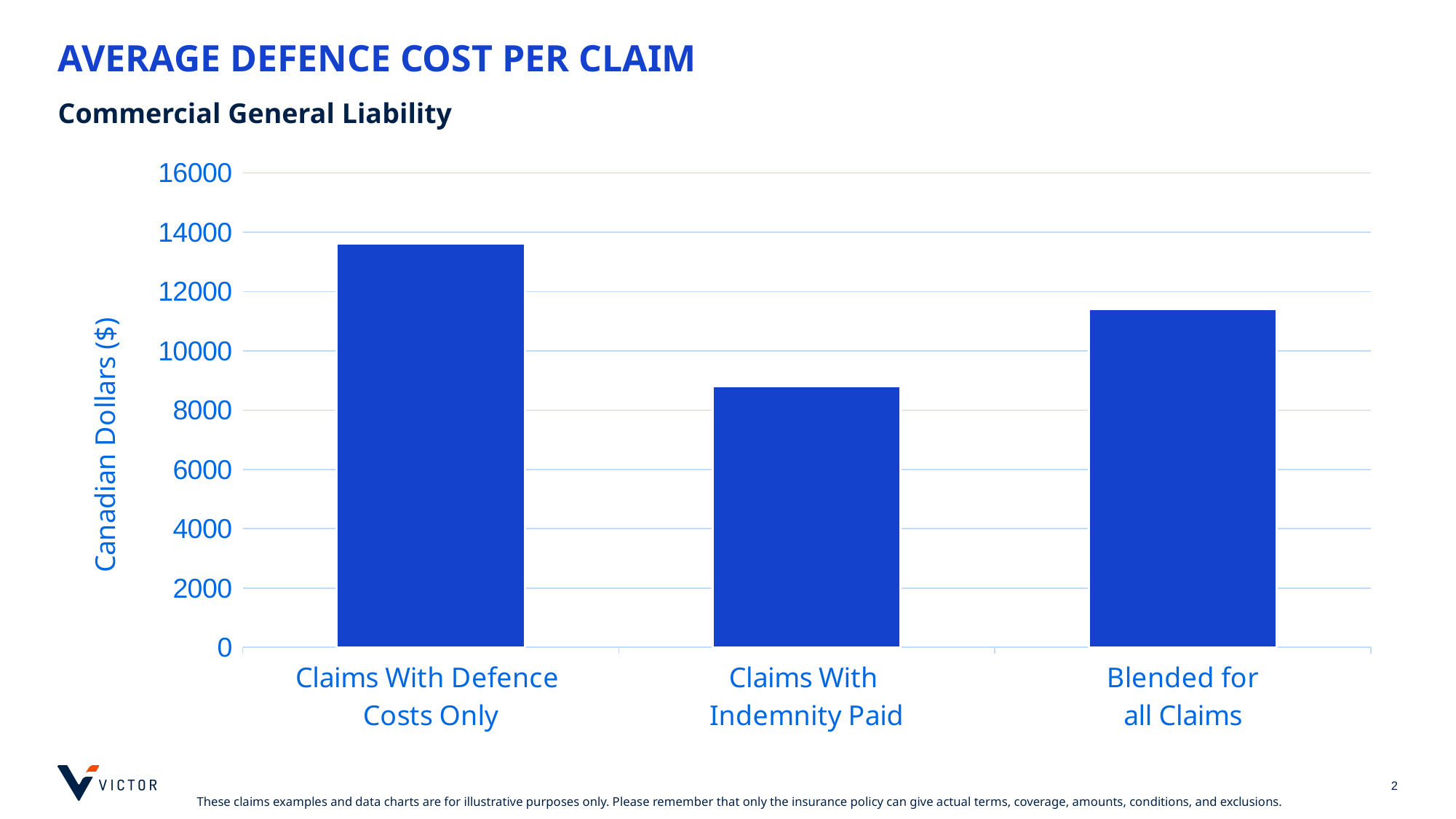
Is the value for Claims With Indemnity Paid greater or less than 10000? less Is the value for Blended for all Claims greater or less than 10000? greater What kind of chart is shown on the slide? bar chart How many categories are plotted on the chart? 3 Which category has the highest average defence cost per claim? Claims With Defence Costs Only What is the title of the chart? AVERAGE DEFENCE COST PER CLAIM Which is larger: the value for Claims With Defence Costs Only or the value for Blended for all Claims? Claims With Defence Costs Only Is the value for Claims With Defence Costs Only greater or less than 14000? less What is the label of the vertical axis? Canadian Dollars ($) Which category has the lowest average defence cost per claim? Claims With Indemnity Paid Which is larger: the value for Claims With Indemnity Paid or the value for Blended for all Claims? Blended for all Claims